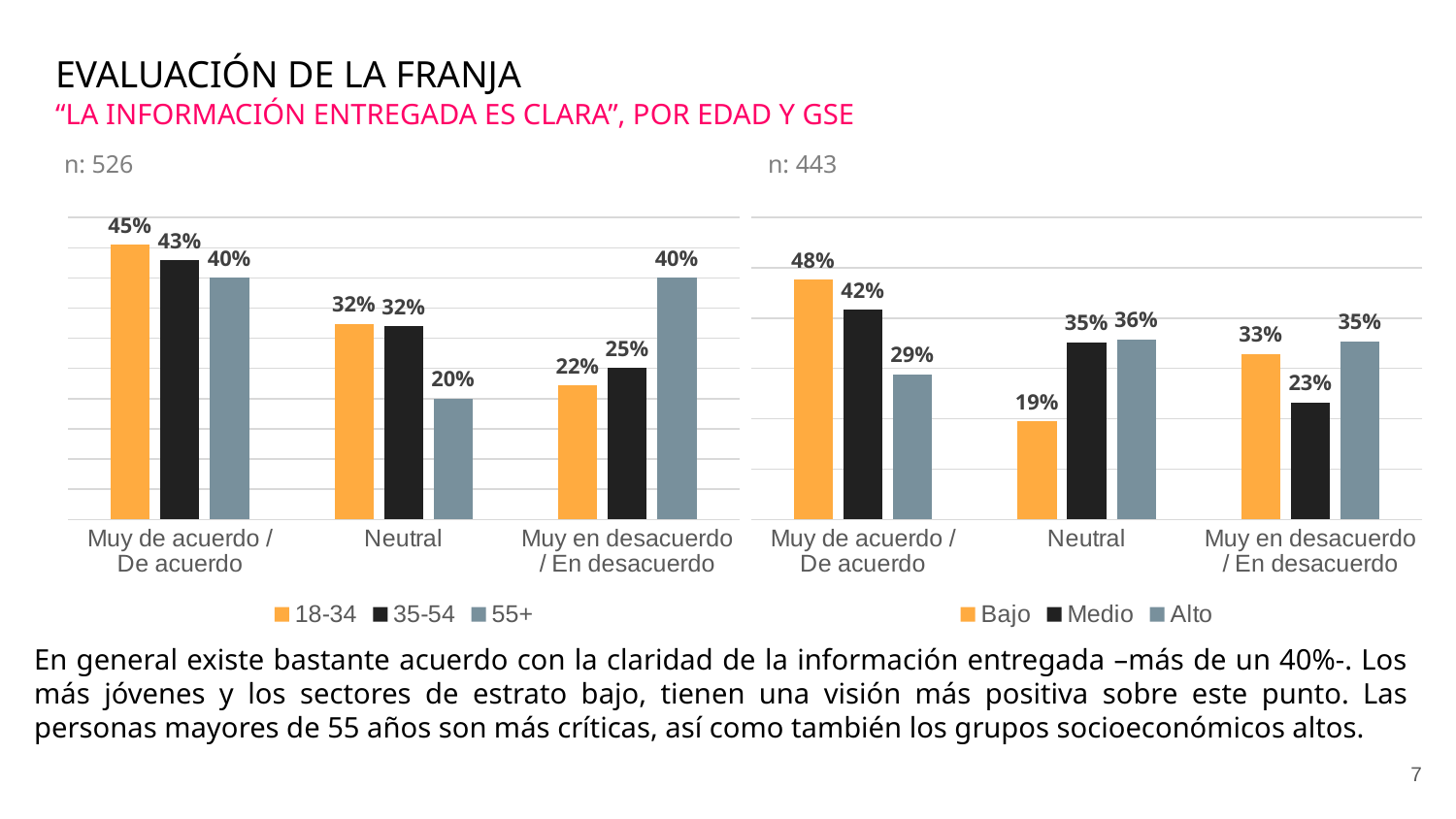
In the right chart (by GSE), what is the difference between the Bajo and Alto values in the 'Muy de acuerdo / De acuerdo' category? 19% In the left chart (by age, n: 526), what is the value for 18-34 in the 'Muy de acuerdo / De acuerdo' category? 45% In the left chart (by age), how many series does the legend list? 3 In the right chart (by GSE), which group has the lowest value in the 'Neutral' category? Bajo In the left chart (by age), which age group has the highest value in the 'Muy en desacuerdo / En desacuerdo' category? 55+ In the right chart (by GSE), which is larger in the 'Muy de acuerdo / De acuerdo' category: Medio or Alto? Medio In the left chart (by age), what is the value for 55+ in the 'Neutral' category? 20% In the right chart (by GSE), what is the value for Medio in the 'Muy en desacuerdo / En desacuerdo' category? 23% In the right chart (by GSE, n: 443), what is the value for Bajo in the 'Muy de acuerdo / De acuerdo' category? 48% How many categories are shown on the x axis of the right chart (by GSE)? 3 What type of chart is the left chart (by age)? Bar chart In the left chart (by age), what is the difference between the 55+ and 18-34 values in the 'Muy en desacuerdo / En desacuerdo' category? 18%